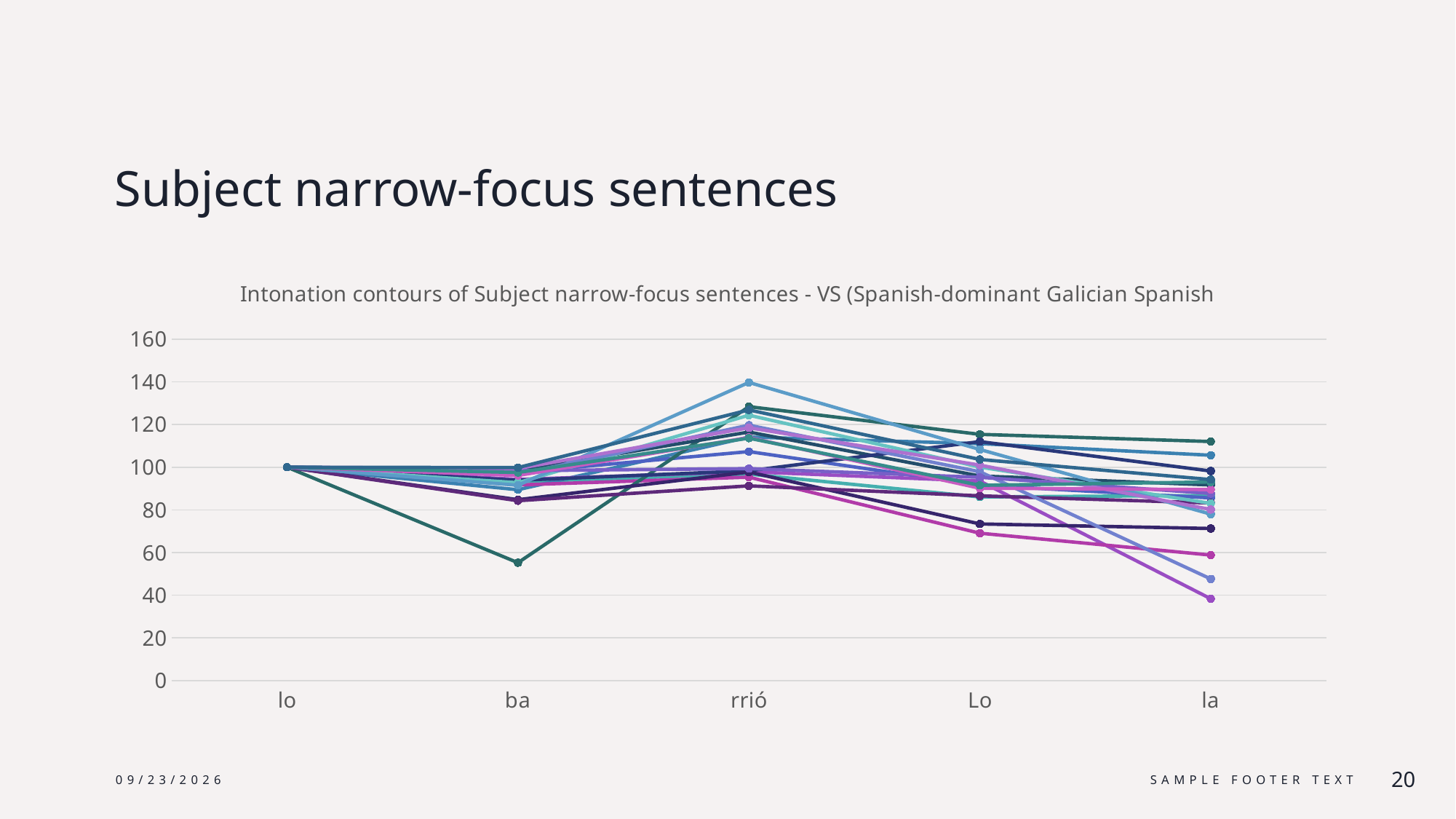
What is the title of the chart? Intonation contours of Subject narrow-focus sentences - VS (Spanish-dominant Galician Spanish How many categories are shown on the x axis? 5 What is the highest value shown on the y axis? 160 What value do all the lines share at the category 'lo'? 100 Is the lowest value at 'la' greater or less than 60? less Is the lowest value at 'Lo' greater or less than 80? less Is the lowest value at 'ba' greater or less than 80? less At which category does the lowest point of any line occur? la Do most lines rise or fall between 'rrió' and 'la'? fall At which category does the highest point of any line occur? rrió What kind of chart is shown on the slide? line chart